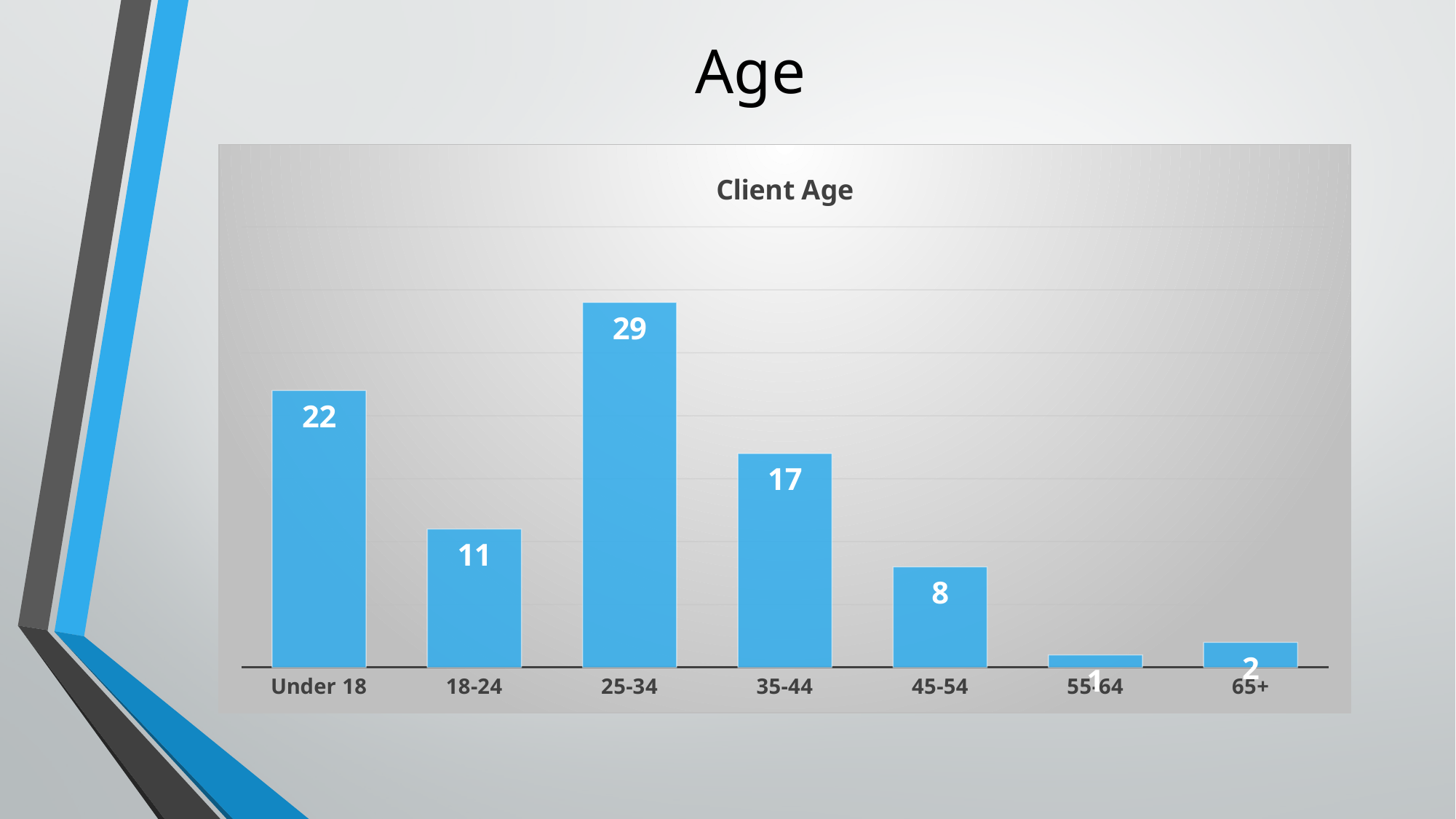
What is the value for the Under 18 age group? 22 What is the difference between the values for Under 18 and 18-24? 11 Which age group has the lowest value? 55-64 What is the value for the 45-54 age group? 8 What is the value for the 65+ age group? 2 Which age group has the highest value? 25-34 Which is larger, the value for 35-44 or the value for 45-54? 35-44 What is the difference between the values for 25-34 and 35-44? 12 How many age groups are shown on the chart? 7 What is the value for the 25-34 age group? 29 What is the title of the chart? Client Age What kind of chart is shown on the slide? Bar chart